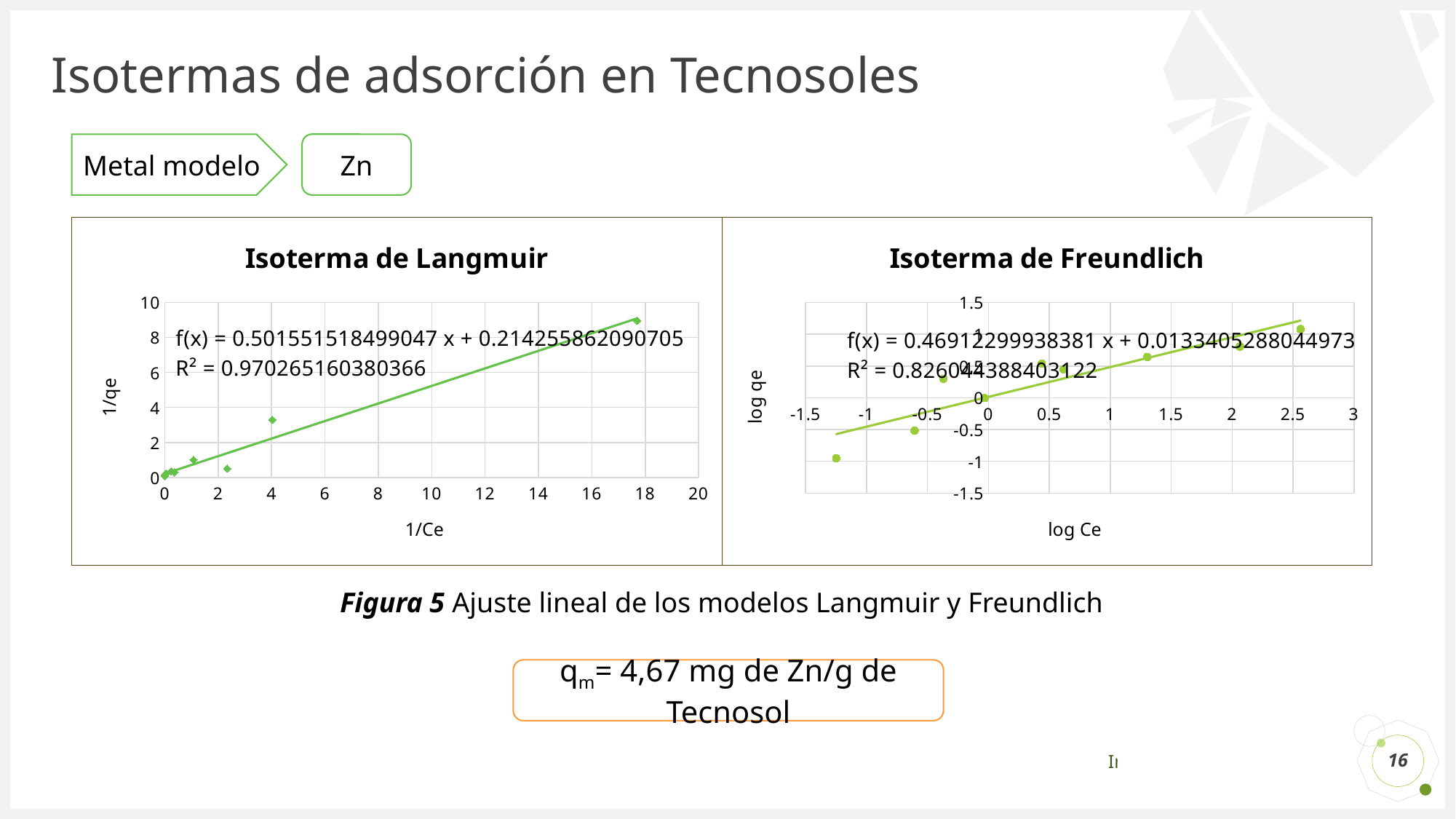
What is the y-axis label of the 'Isoterma de Freundlich' chart? log qe On the 'Isoterma de Freundlich' chart, is the log qe value of the leftmost point greater or less than -0.5? less How many data points are plotted on the 'Isoterma de Freundlich' chart? 9 Which chart shows the higher R² value, 'Isoterma de Langmuir' or 'Isoterma de Freundlich'? Isoterma de Langmuir What is the R² value shown on the 'Isoterma de Freundlich' chart? 0.826044388403122 What is the slope of the fitted line f(x) on the 'Isoterma de Langmuir' chart? 0.501551518499047 On the 'Isoterma de Langmuir' chart, is the 1/qe value of the rightmost point greater or less than 8? greater What kind of chart is the 'Isoterma de Langmuir' chart? scatter chart On the 'Isoterma de Freundlich' chart, do the plotted values rise or fall as log Ce increases? rise What is the x-axis label of the 'Isoterma de Langmuir' chart? 1/Ce What is the R² value shown on the 'Isoterma de Langmuir' chart? 0.970265160380366 What is the intercept of the fitted line f(x) on the 'Isoterma de Freundlich' chart? 0.0133405288044973